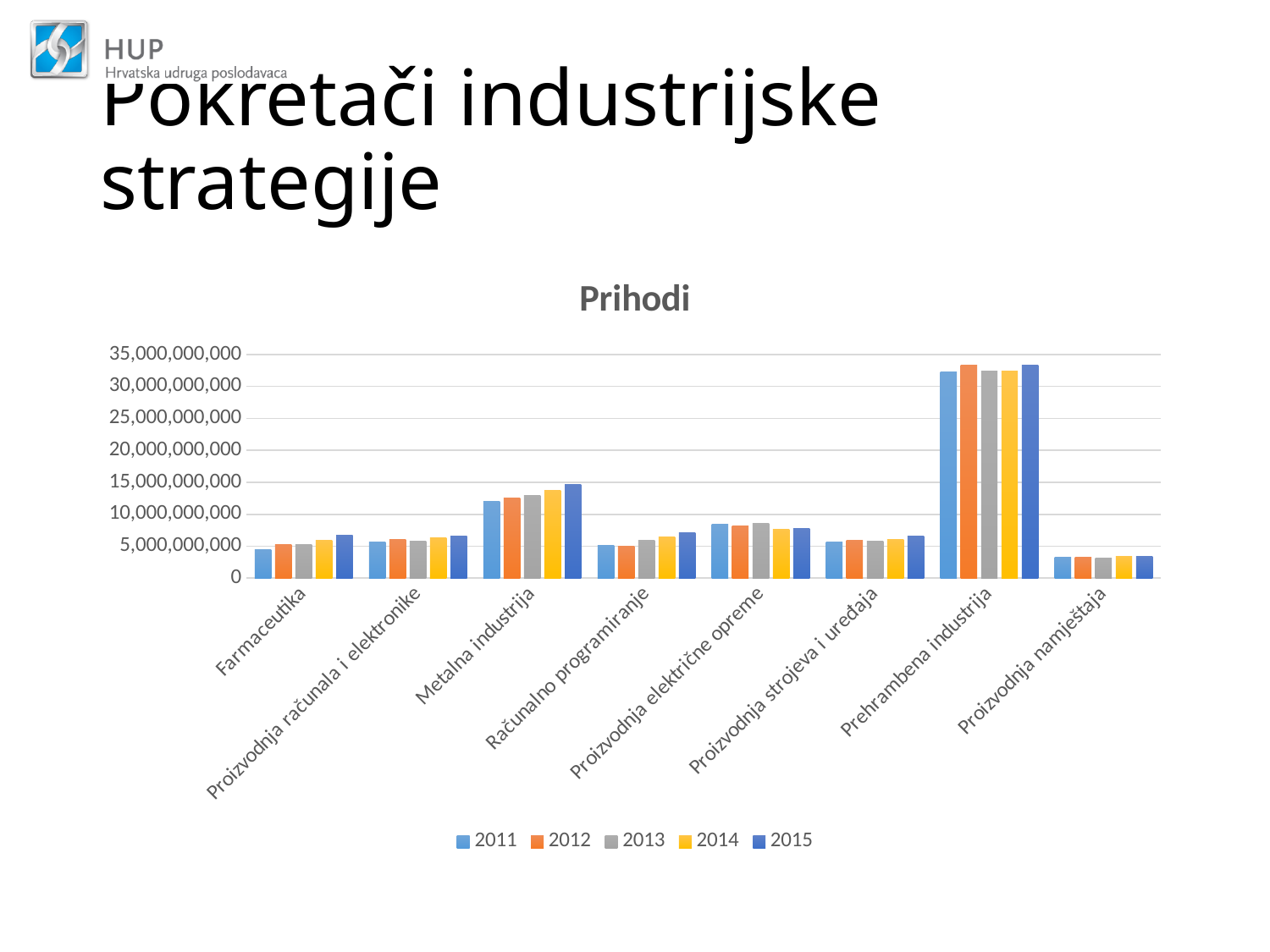
What kind of chart is shown on the slide? bar chart Which category has the lowest revenue values? Proizvodnja namještaja How many series does the legend list? 5 Is the 2011 value for Metalna industrija greater or less than 10,000,000,000? greater Is the 2011 value for Proizvodnja namještaja greater or less than 5,000,000,000? less Which colour represents the 2014 series in the legend? yellow How many industry categories are shown on the x axis? 8 Which category has the highest revenue values? Prehrambena industrija What is the title of the chart? Prihodi Which is larger in 2015: Metalna industrija or Proizvodnja električne opreme? Metalna industrija Do the values for Metalna industrija rise or fall from 2011 to 2015? rise Is the 2015 value for Prehrambena industrija greater or less than 30,000,000,000? greater